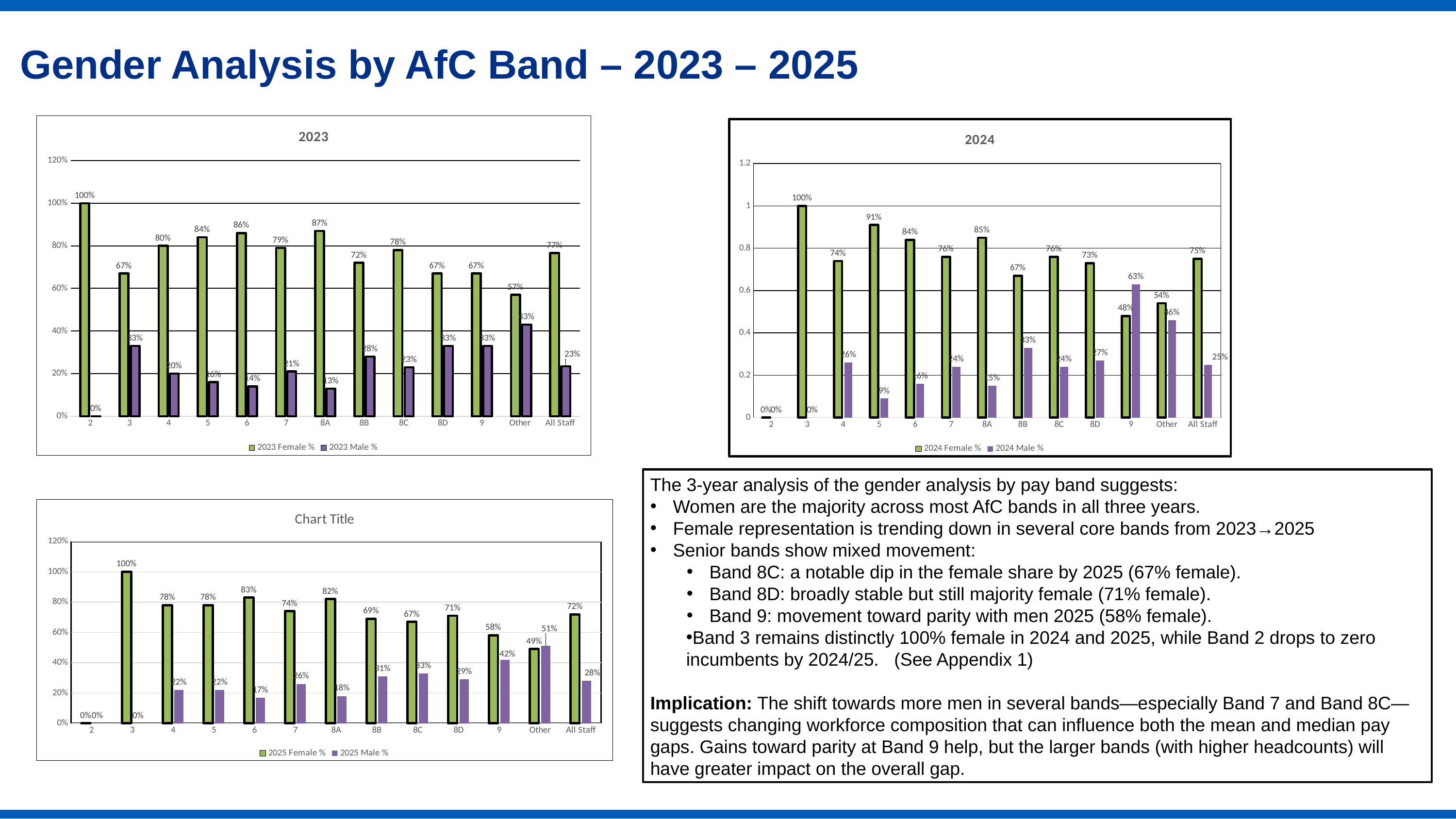
In the 2023 chart, what is the 2023 Female % for band 8A? 87% In the chart titled 'Chart Title', what is the difference between the 2025 Female % for band 9 and the 2025 Male % for band 9? 16% In the 2024 chart, what is the 2024 Female % for band 5? 91% In the 2023 chart, what is the 2023 Male % for the Other category? 43% In the 2024 chart, what is the 2024 Male % for band 8B? 33% In the chart titled 'Chart Title', what is the 2025 Female % for band 8C? 67% In the 2024 chart, which is larger for band 9: the 2024 Female % or the 2024 Male %? 2024 Male % In the 2023 chart, which category has the highest 2023 Female %? 2 How many series does the legend of the 2024 chart list? 2 How many categories are shown on the x axis of the 2023 chart? 13 In the 2023 chart, what is the difference between the 2023 Female % and 2023 Male % for All Staff? 54% In the chart titled 'Chart Title', which category has the highest 2025 Male %? Other